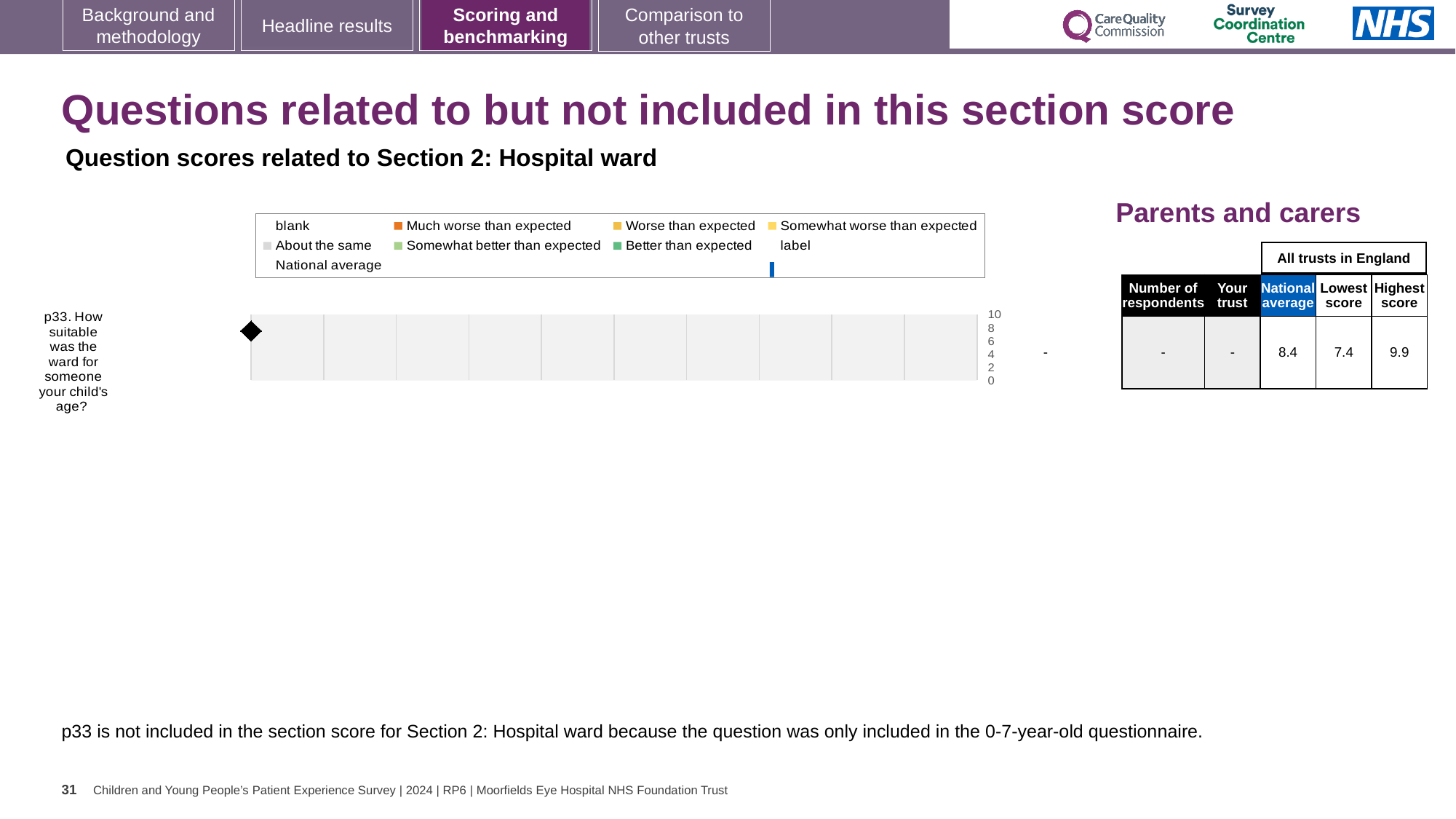
How many survey questions are plotted on the chart? 1 In the table, is the national average for p33 greater or less than the lowest score? greater What colour does the legend use for 'Much worse than expected'? orange What value is shown for the trust on the chart for p33? - What is the highest value shown on the chart's axis? 10 In the table, what is the lowest score across all trusts in England for p33? 7.4 What kind of chart is shown on the slide? bar chart In the table, what is the national average score for p33? 8.4 In the table, what is the difference between the highest score and the lowest score for p33? 2.5 In the table, what is the highest score across all trusts in England for p33? 9.9